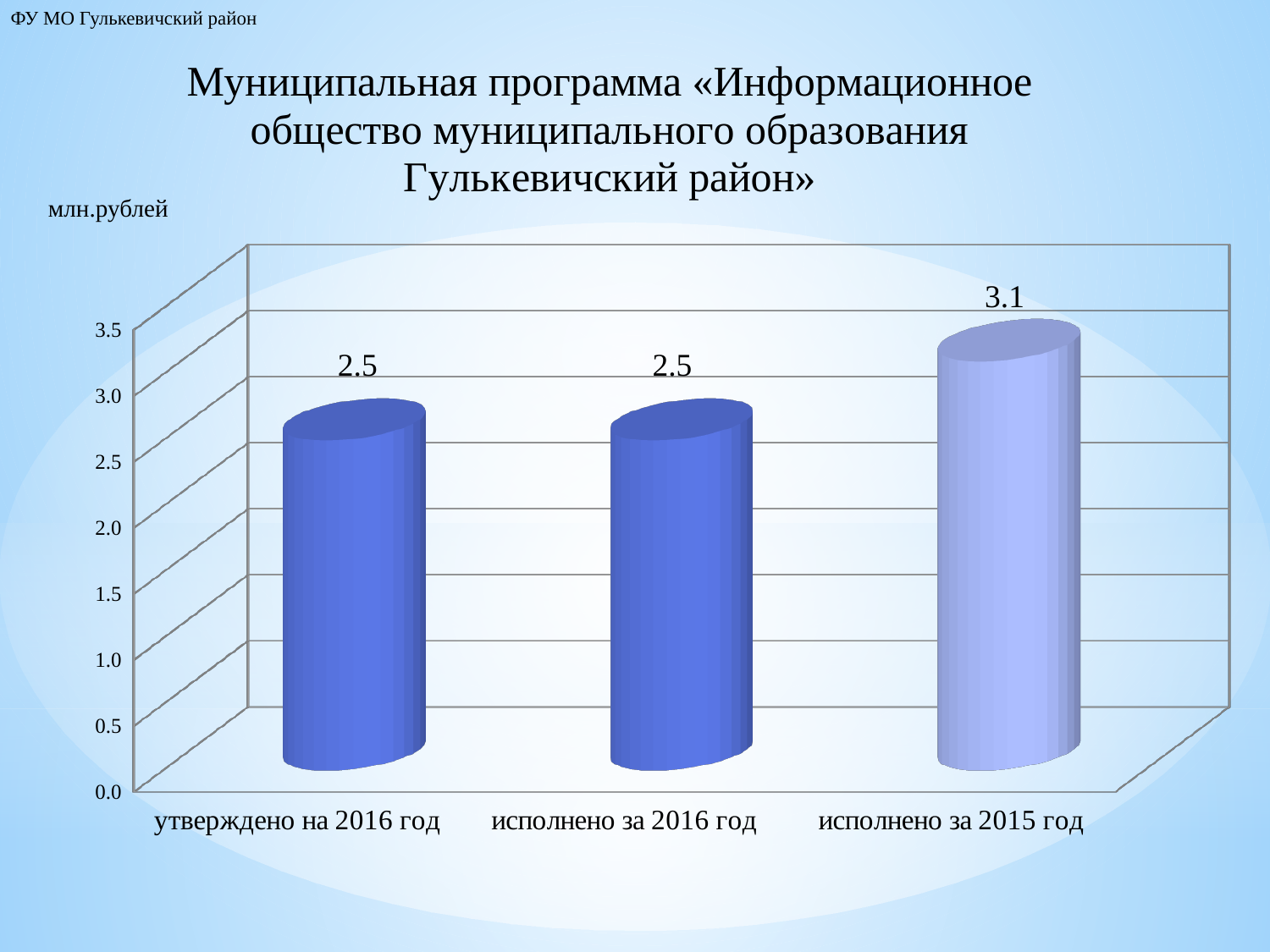
What is the value for «исполнено за 2015 год»? 3.1 Is the value for «утверждено на 2016 год» greater or less than 3.0? less What is the value for «исполнено за 2016 год»? 2.5 Which category has the highest value? исполнено за 2015 год What unit is indicated above the chart? млн.рублей Which is larger: the value for «исполнено за 2015 год» or the value for «утверждено на 2016 год»? исполнено за 2015 год What is the difference between the value for «исполнено за 2015 год» and the value for «исполнено за 2016 год»? 0.6 What is the total of the values for «утверждено на 2016 год» and «исполнено за 2016 год»? 5.0 How many categories are shown on the chart? 3 What is the value for «утверждено на 2016 год»? 2.5 What kind of chart is shown on the slide? bar chart Is the value for «исполнено за 2015 год» greater or less than 3.0? greater